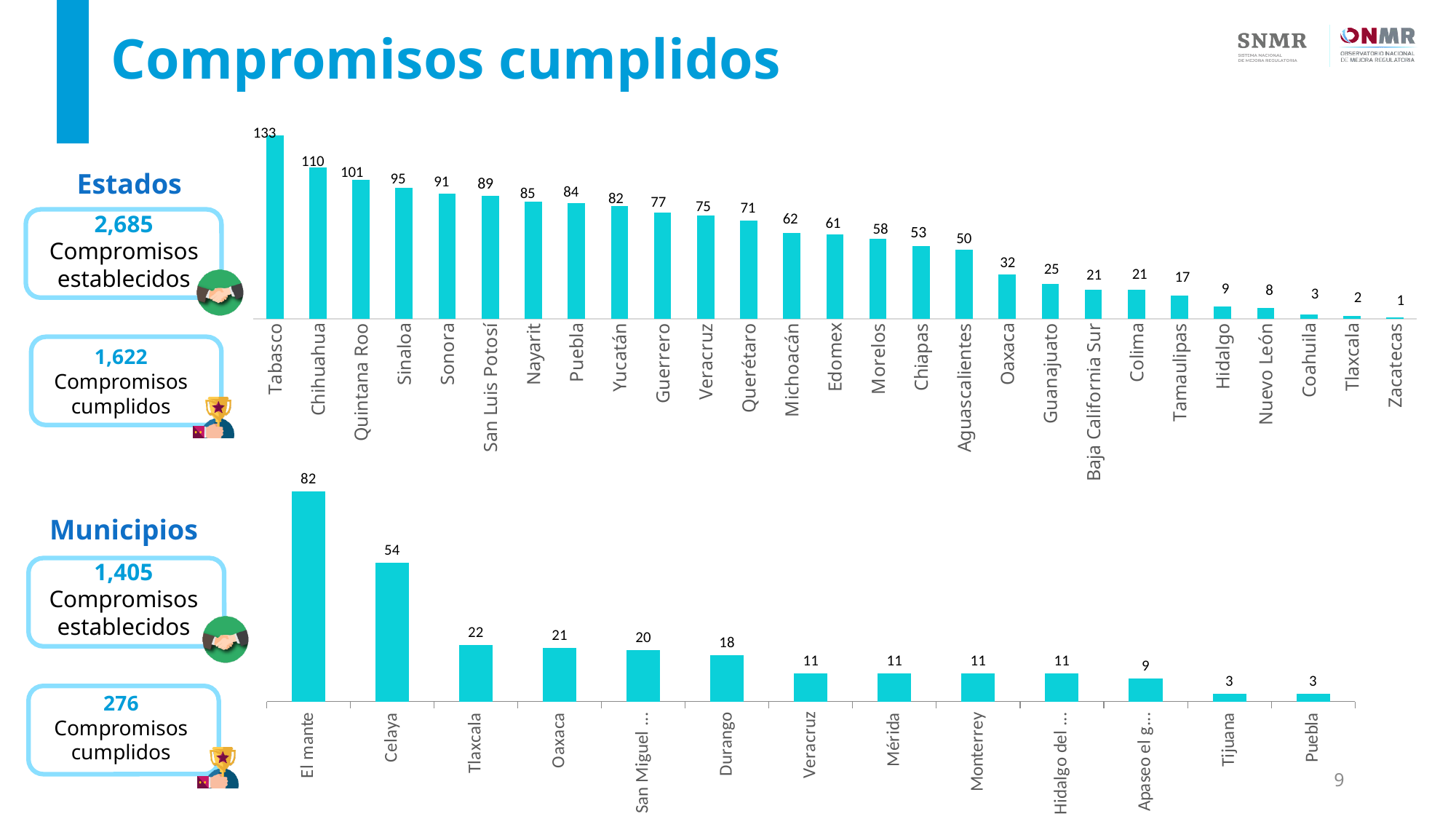
In the Municipios chart (bottom), what is the difference between El mante and Celaya? 28 What kind of chart is the Municipios chart (bottom)? Bar chart In the Estados chart (top), which state has the lowest value? Zacatecas In the Municipios chart (bottom), which municipality has the highest value? El mante In the Estados chart (top), do the values rise or fall from left to right? Fall In the Estados chart (top), how many states are shown? 27 In the Estados chart (top), which is larger, Morelos or Chiapas? Morelos In the Municipios chart (bottom), what is the value for Celaya? 54 In the Municipios chart (bottom), how many municipalities are shown? 13 In the Estados chart (top), what is the difference between Chihuahua and Quintana Roo? 9 In the Estados chart (top), what is the value for Tabasco? 133 In the Estados chart (top), what is the value for Querétaro? 71